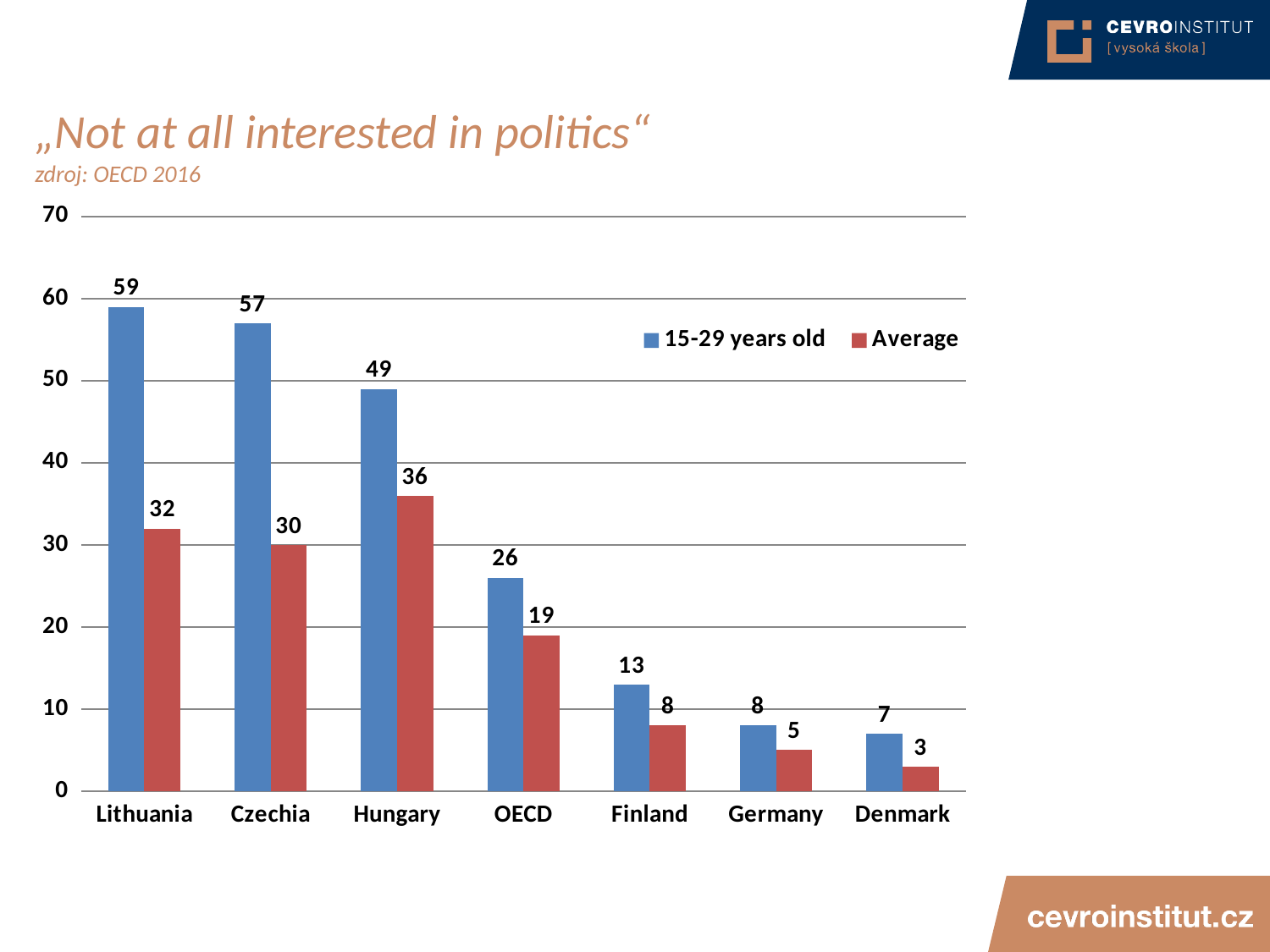
What is the source given under the chart title? OECD 2016 How many categories are shown on the x axis? 7 Do the 15-29 years old values rise or fall from Lithuania to Denmark along the x axis? Fall What is the value for 15-29 years old in Lithuania? 59 How many series does the legend list? 2 What is the value for 15-29 years old for the OECD? 26 Which is larger: the 15-29 years old value for Finland or the 15-29 years old value for Germany? Finland What kind of chart is shown on the slide? Bar chart Which category has the lowest Average value? Denmark Which category has the highest value for 15-29 years old? Lithuania What is the Average value for Hungary? 36 What is the difference between the 15-29 years old value and the Average value for Czechia? 27